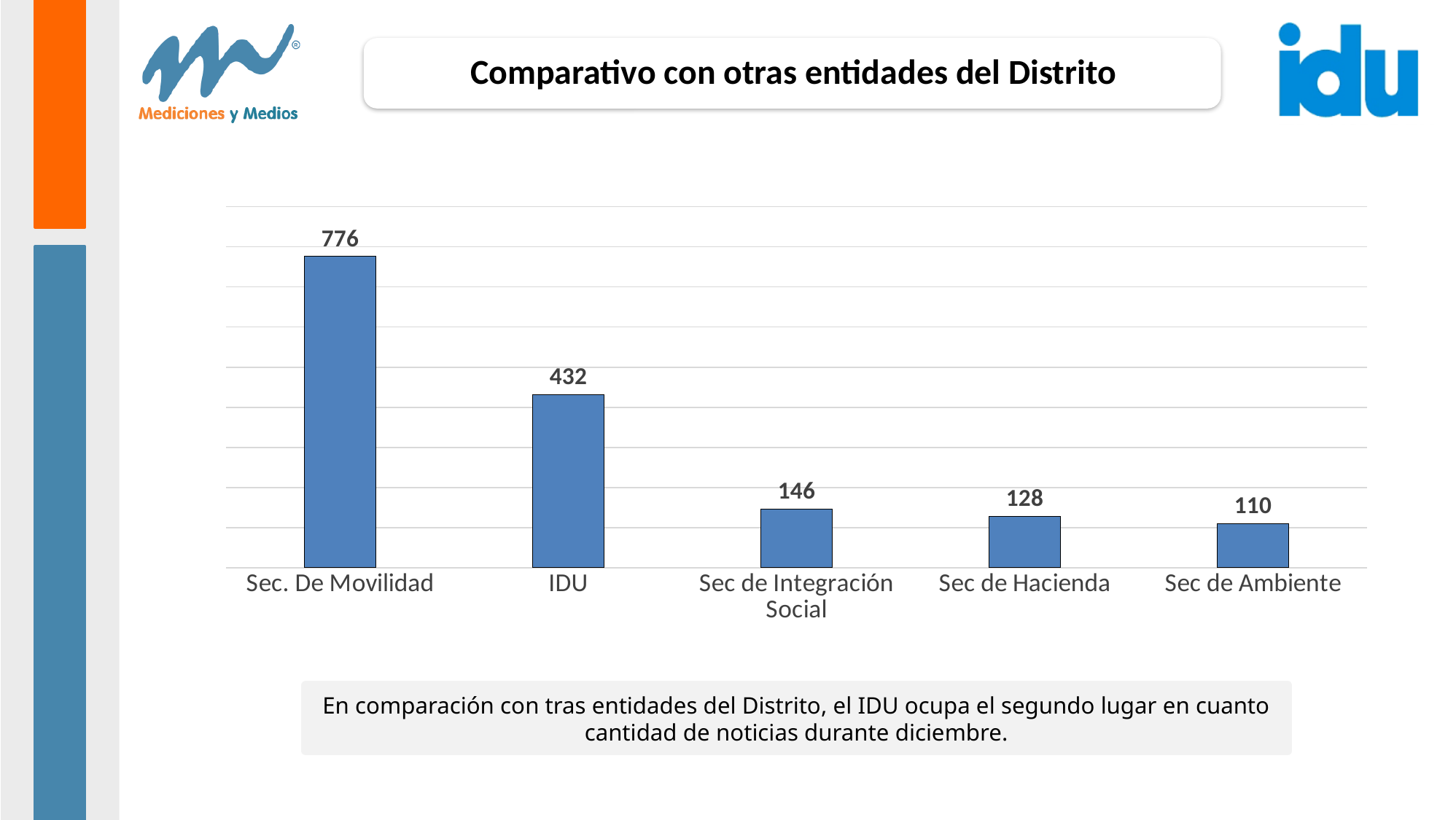
Which is larger, the value for Sec de Hacienda or Sec de Integración Social? Sec de Integración Social What is the value for IDU? 432 What is the value for Sec de Integración Social? 146 Which category has the highest value? Sec. De Movilidad Which category has the lowest value? Sec de Ambiente What is the value for Sec de Ambiente? 110 What is the value for Sec de Hacienda? 128 Do the values rise or fall from left to right along the x axis? Fall How many categories are shown in the chart? 5 What is the value for Sec. De Movilidad? 776 What kind of chart is shown on the slide? Bar chart What is the difference between the values for Sec. De Movilidad and IDU? 344